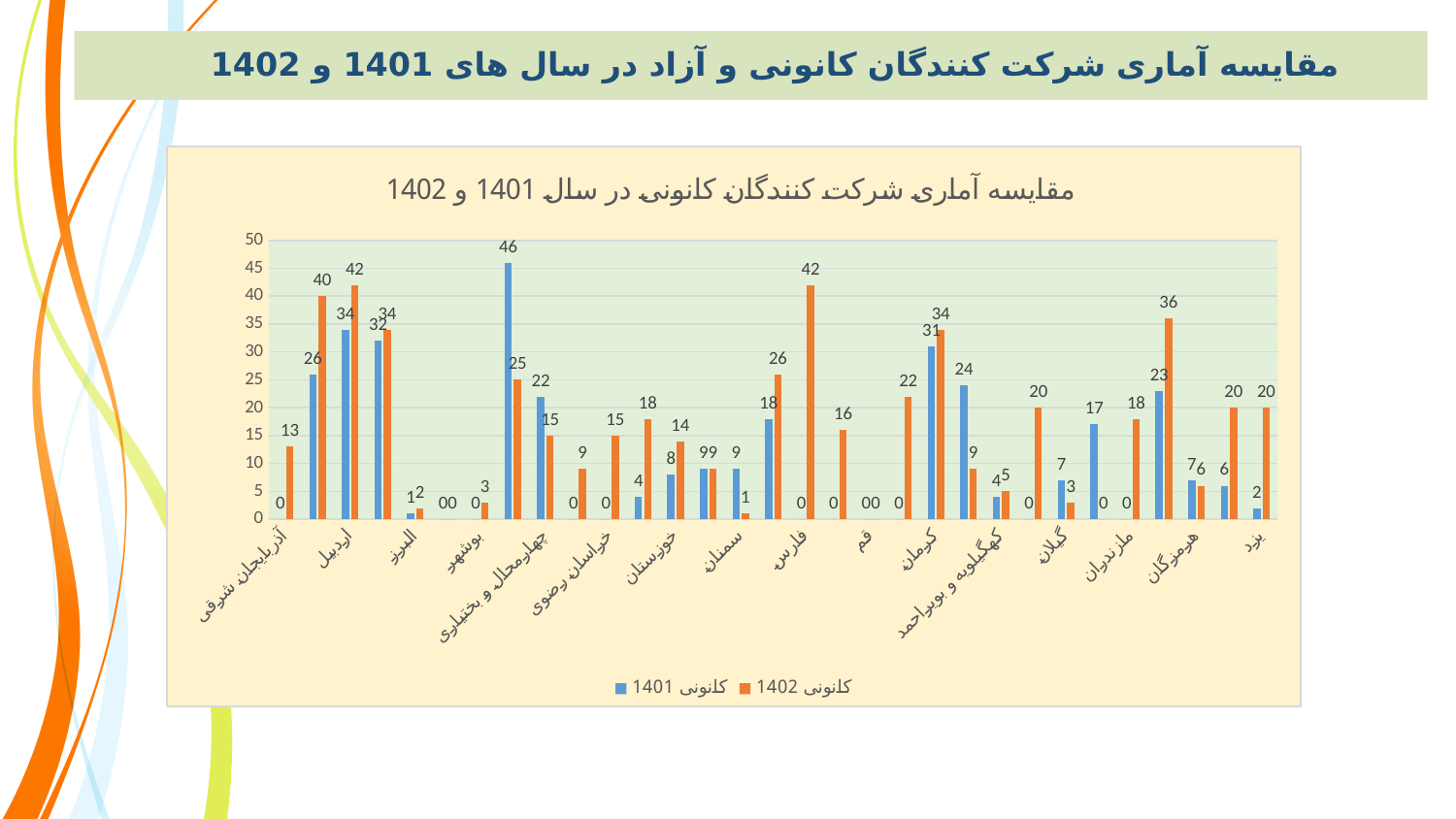
For یزد, which series has the larger value, کانونی 1401 or کانونی 1402? کانونی 1402 What is the value for آذربایجان شرقی in the کانونی 1402 series? 13 What is the difference between the کانونی 1402 and کانونی 1401 values for کرمان? 3 What is the maximum value shown on the vertical axis? 50 What is the value for کرمان in the کانونی 1401 series? 31 How many series does the legend list? 2 What is the highest value shown for the کانونی 1401 series? 46 What are the two series named in the legend? کانونی 1401 and کانونی 1402 What type of chart is shown on the slide? bar chart What is the highest value shown for the کانونی 1402 series? 42 What is the value for فارس in the کانونی 1402 series? 42 What is the title of the chart? مقایسه آماری شرکت کنندگان کانونی در سال 1401 و 1402